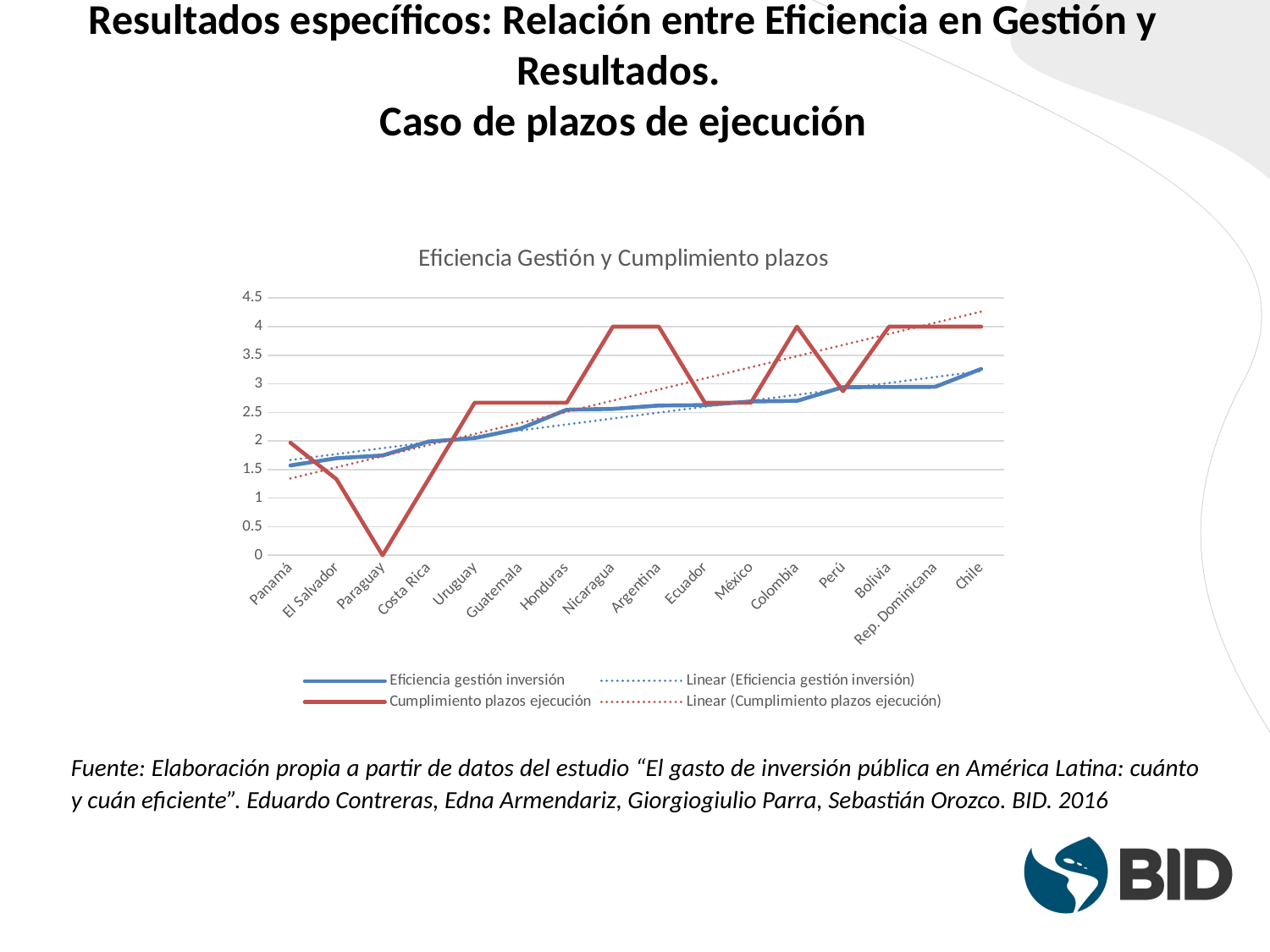
Is the value of Eficiencia gestión inversión for Chile greater or less than 3? greater What is the value of Cumplimiento plazos ejecución for Paraguay? 0 What kind of chart is shown on the slide? Line chart How many entries does the chart legend list? 4 Does the Eficiencia gestión inversión line generally rise or fall from Panamá to Chile? Rise For Nicaragua, which series has the larger value: Eficiencia gestión inversión or Cumplimiento plazos ejecución? Cumplimiento plazos ejecución Which country has the lowest value for Cumplimiento plazos ejecución? Paraguay How many countries are shown along the x axis of the chart? 16 What is the value of Cumplimiento plazos ejecución for Nicaragua? 4 Is the value of Eficiencia gestión inversión for Panamá greater or less than 2? less What is the title of the chart? Eficiencia Gestión y Cumplimiento plazos Which country has the highest value for Eficiencia gestión inversión? Chile